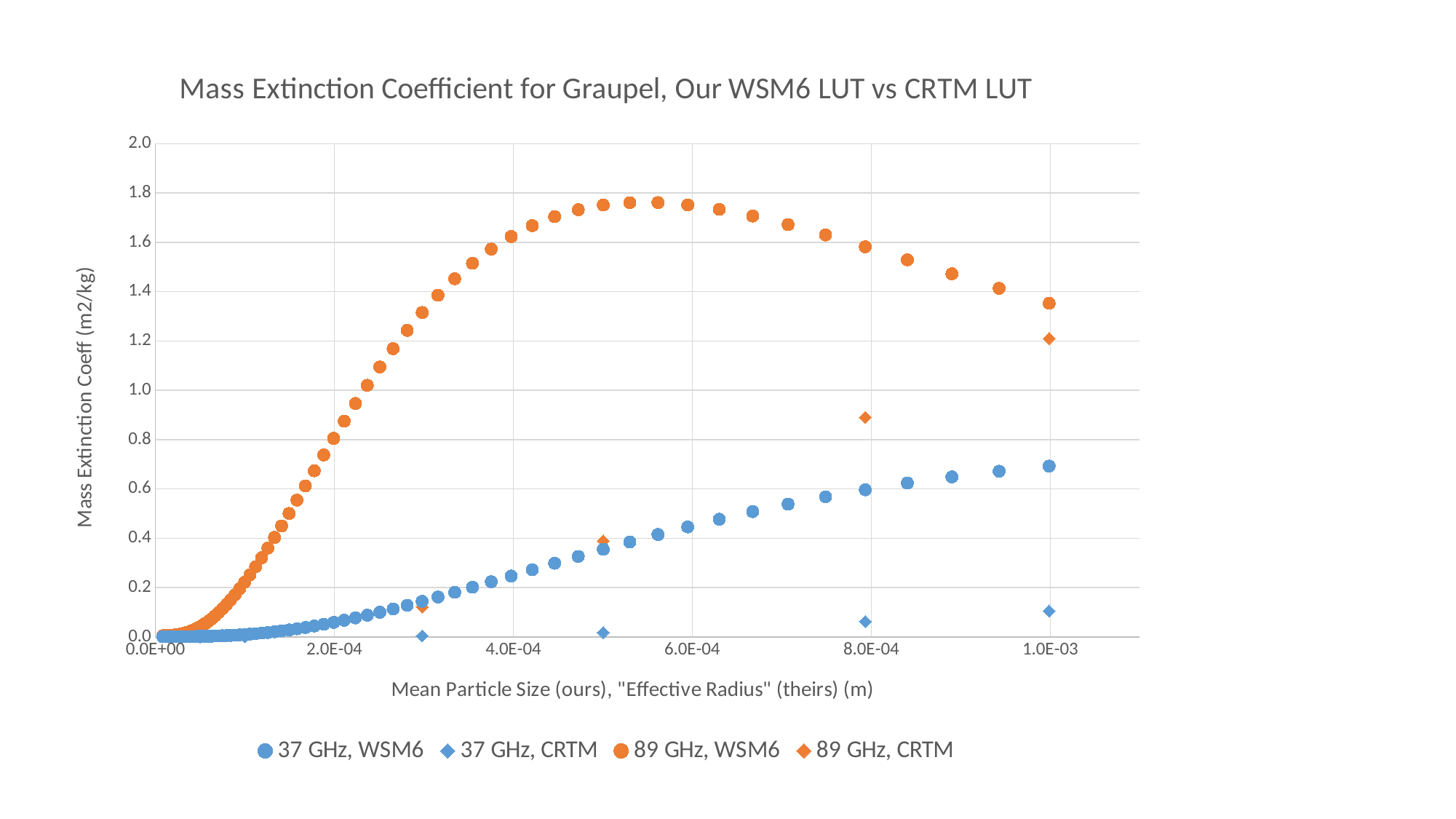
Is the 89 GHz, CRTM value at 1.0E-03 greater or less than 1.0? greater What kind of chart is shown on the slide? Scatter chart At 8.0E-04, which is larger: the 89 GHz, WSM6 value or the 89 GHz, CRTM value? 89 GHz, WSM6 Is the peak value of the 89 GHz, WSM6 series greater or less than 1.6? greater Which series reaches the highest mass extinction coefficient on the chart? 89 GHz, WSM6 What is the title of the chart? Mass Extinction Coefficient for Graupel, Our WSM6 LUT vs CRTM LUT What is the label of the y axis? Mass Extinction Coeff (m2/kg) How many series does the legend list? 4 Does the 37 GHz, WSM6 series rise or fall as particle size increases along the x axis? rise Is the 37 GHz, CRTM value at 1.0E-03 greater or less than 0.2? less